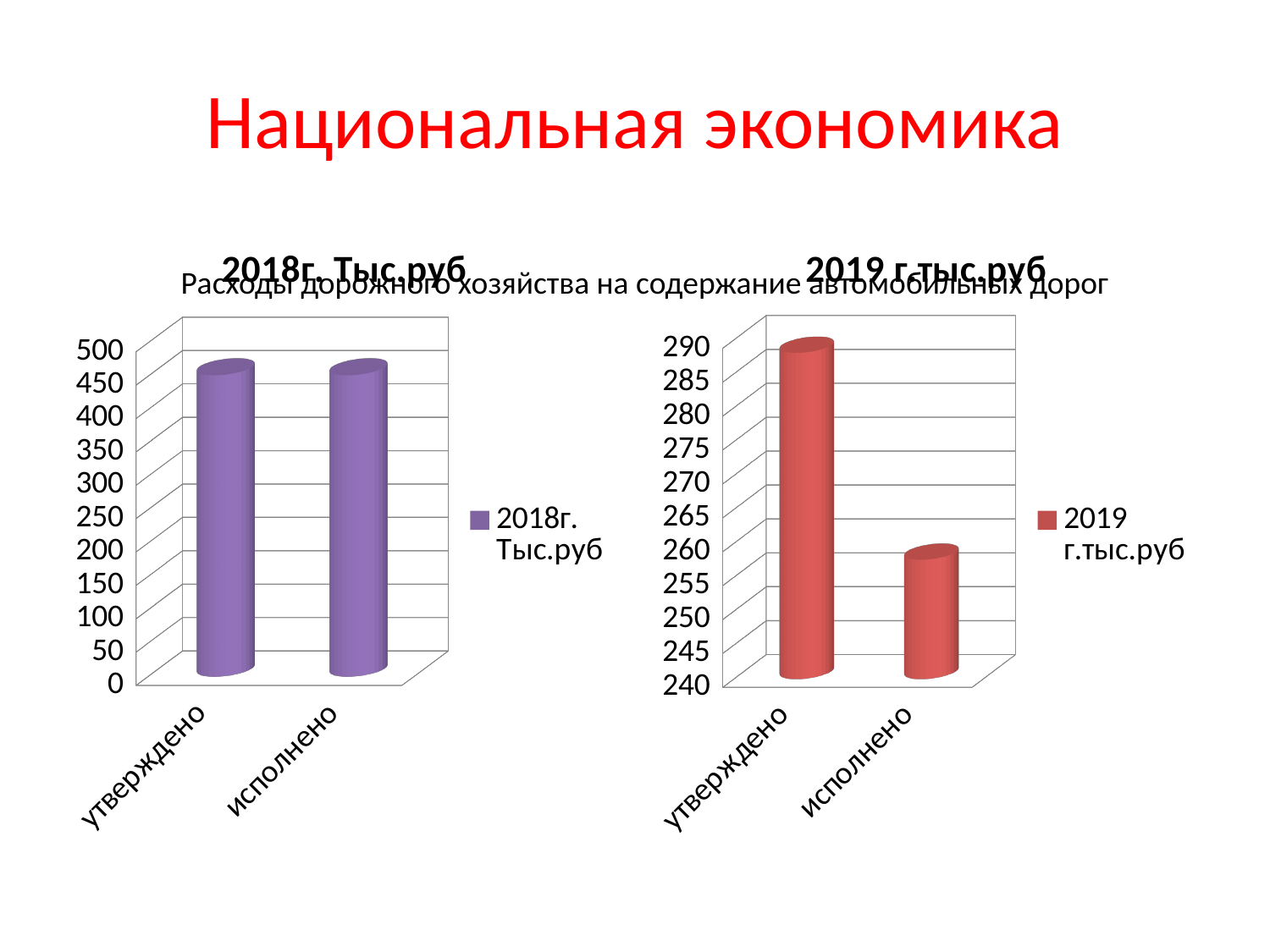
What kind of chart is the right chart titled "2019 г.тыс.руб"? bar chart In the right chart (2019 г.тыс.руб), is the value for утверждено greater or less than 280? greater In the left chart (2018г. Тыс.руб), is the value for утверждено greater or less than 400? greater In the right chart (2019 г.тыс.руб), which category has the higher value, утверждено or исполнено? утверждено In the right chart (2019 г.тыс.руб), how many categories are shown on the x axis? 2 In the right chart (2019 г.тыс.руб), is the value for исполнено greater or less than 270? less In the left chart (2018г. Тыс.руб), how many categories are shown on the x axis? 2 What kind of chart is the left chart titled "2018г. Тыс.руб"? bar chart In the right chart (2019 г.тыс.руб), which category has the lowest value? исполнено In the left chart (2018г. Тыс.руб), how many series does the legend list? 1 In the right chart (2019 г.тыс.руб), what is the legend entry? 2019 г.тыс.руб